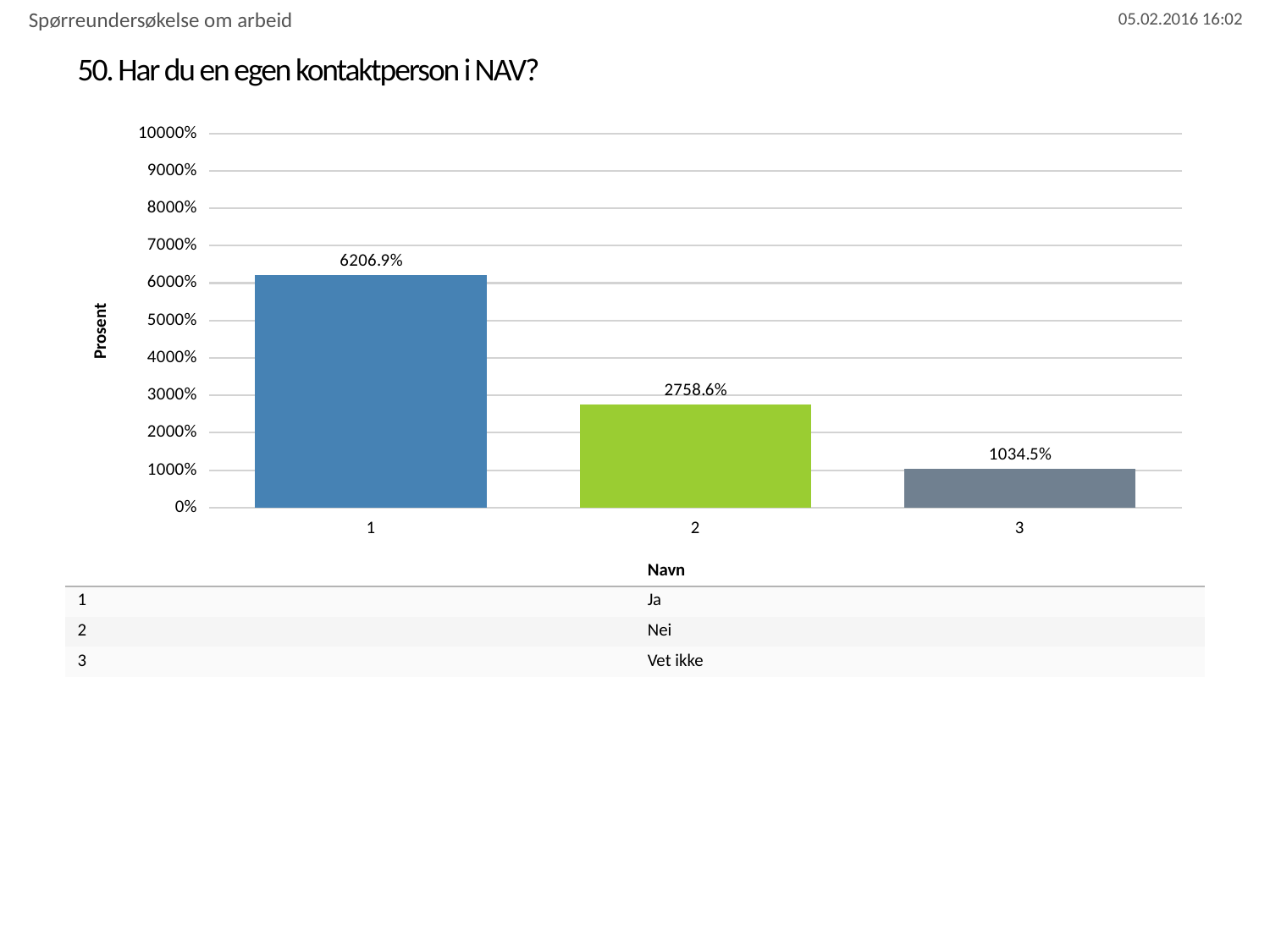
How many bars are in the chart? 3 Is the value for category 2 greater or less than 3000%? less What is the value for category 3? 1034.5% Which category has the highest value? 1 Which is larger, the value for category 2 or category 3? 2 What is the value for category 2? 2758.6% Do the values rise or fall from category 1 to category 3? fall What is the difference between the values for category 1 and category 2? 3448.3% What is the label of the y axis? Prosent What is the value for category 1? 6206.9% What kind of chart is shown? bar chart Which category has the lowest value? 3